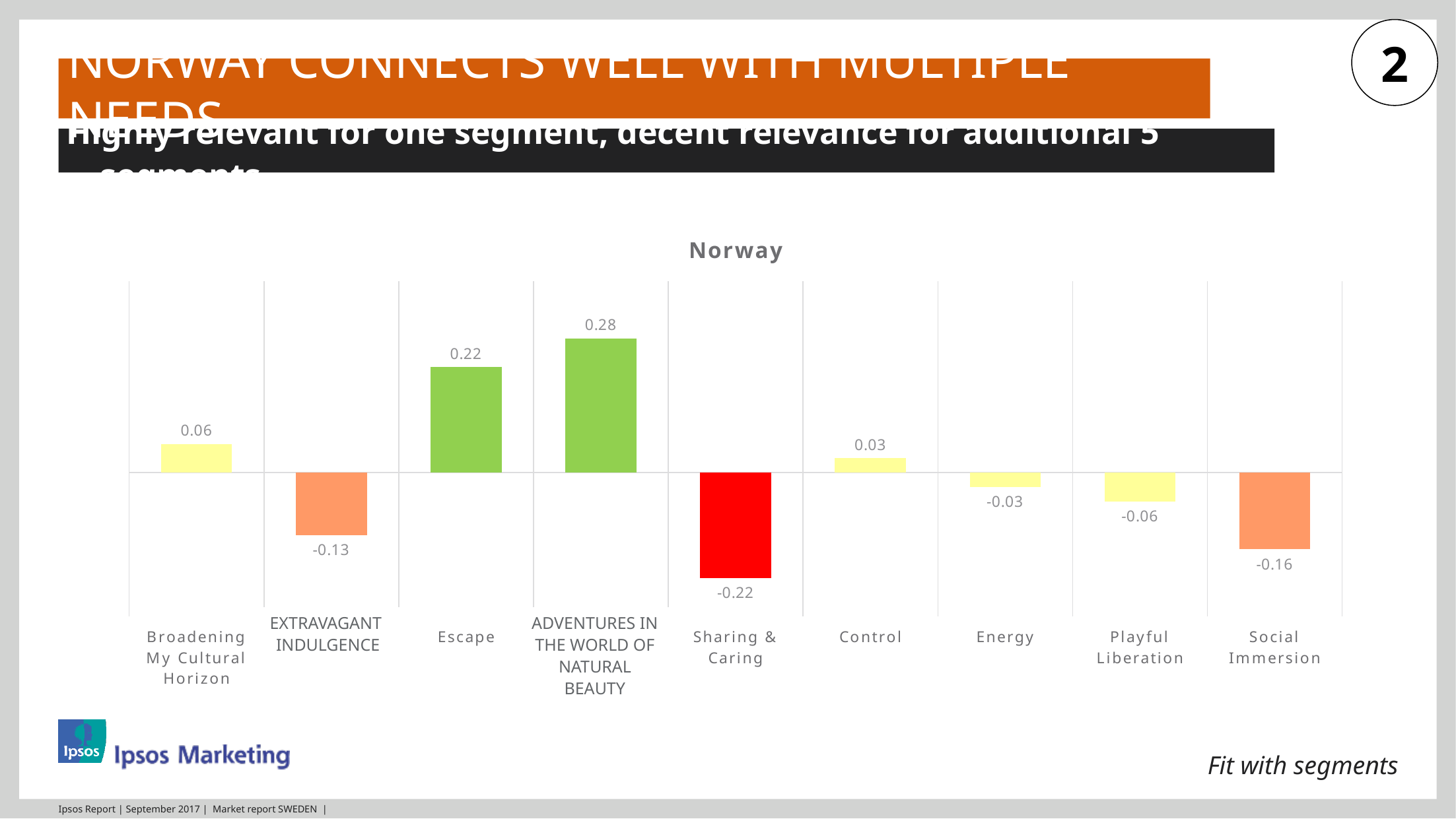
Which category has the highest value? Adventures in the World of Natural Beauty What is the difference between the values for Adventures in the World of Natural Beauty and Escape? 0.06 What is the value for Sharing & Caring? -0.22 What is the value for Escape? 0.22 What is the value for Social Immersion? -0.16 Which category has the lowest value? Sharing & Caring How many categories are shown in the chart? 9 What colour is the bar for Sharing & Caring? Red Which is larger, the value for Broadening My Cultural Horizon or the value for Control? Broadening My Cultural Horizon What kind of chart is shown on the slide? Bar chart What is the title of the chart? Norway What is the value for Control? 0.03